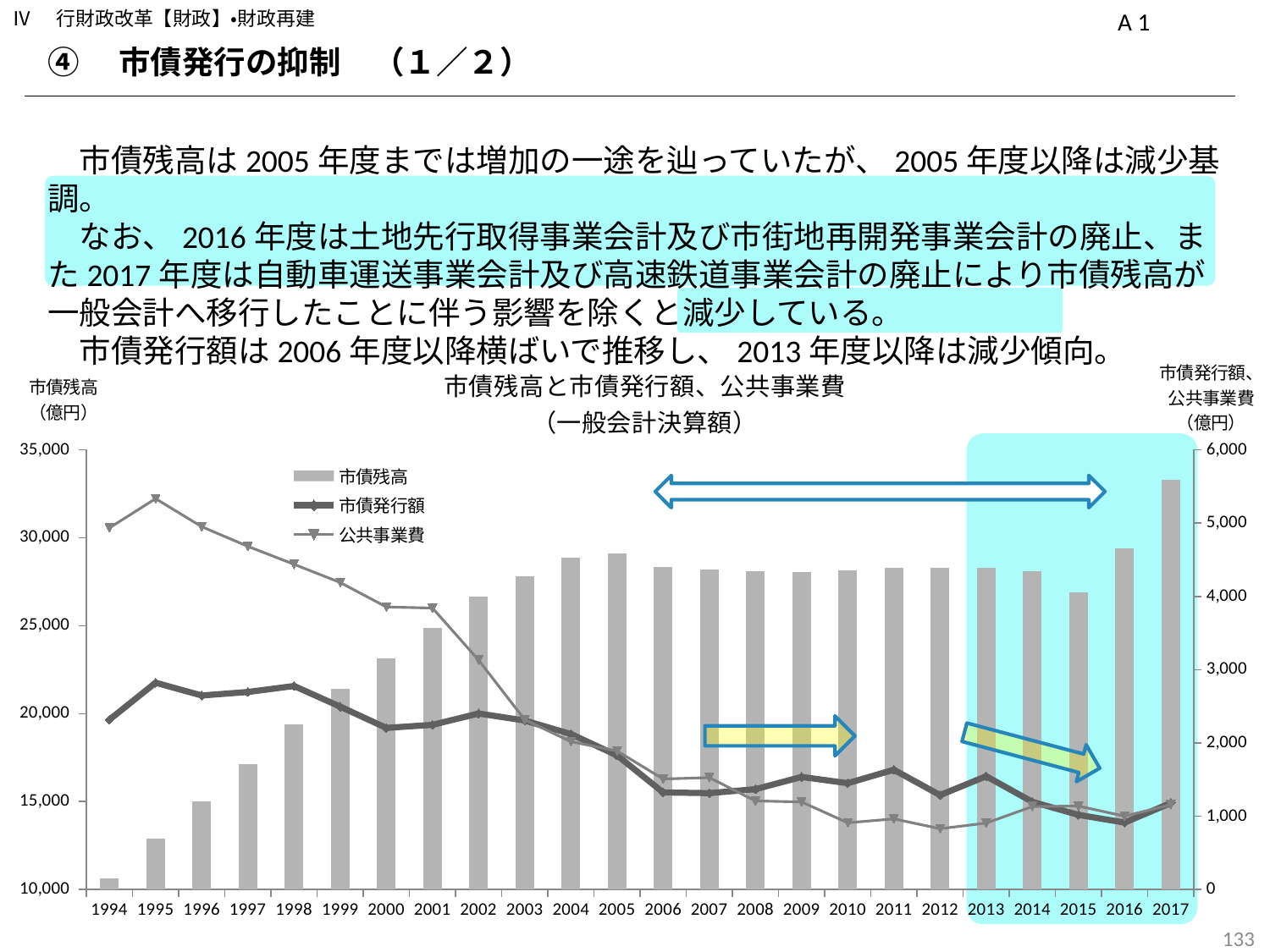
Is the 市債残高 value for 1994 greater or less than 15,000? less Is the 公共事業費 value for 1995 greater or less than 5,000? greater How many series does the chart legend list? 3 What is the title of the chart? 市債残高と市債発行額、公共事業費（一般会計決算額） Is the 市債残高 value for 2017 greater or less than 30,000? greater Does the 公共事業費 line rise or fall from 1995 to 2012? fall Which year has the larger 市債残高 bar, 2000 or 2005? 2005 In which year is the 市債残高 bar the lowest? 1994 Which series in the chart is drawn as bars? 市債残高 In which year is the 市債残高 bar the highest? 2017 What kind of chart is shown on the slide? A combined bar and line chart How many years are shown along the x axis of the chart? 24